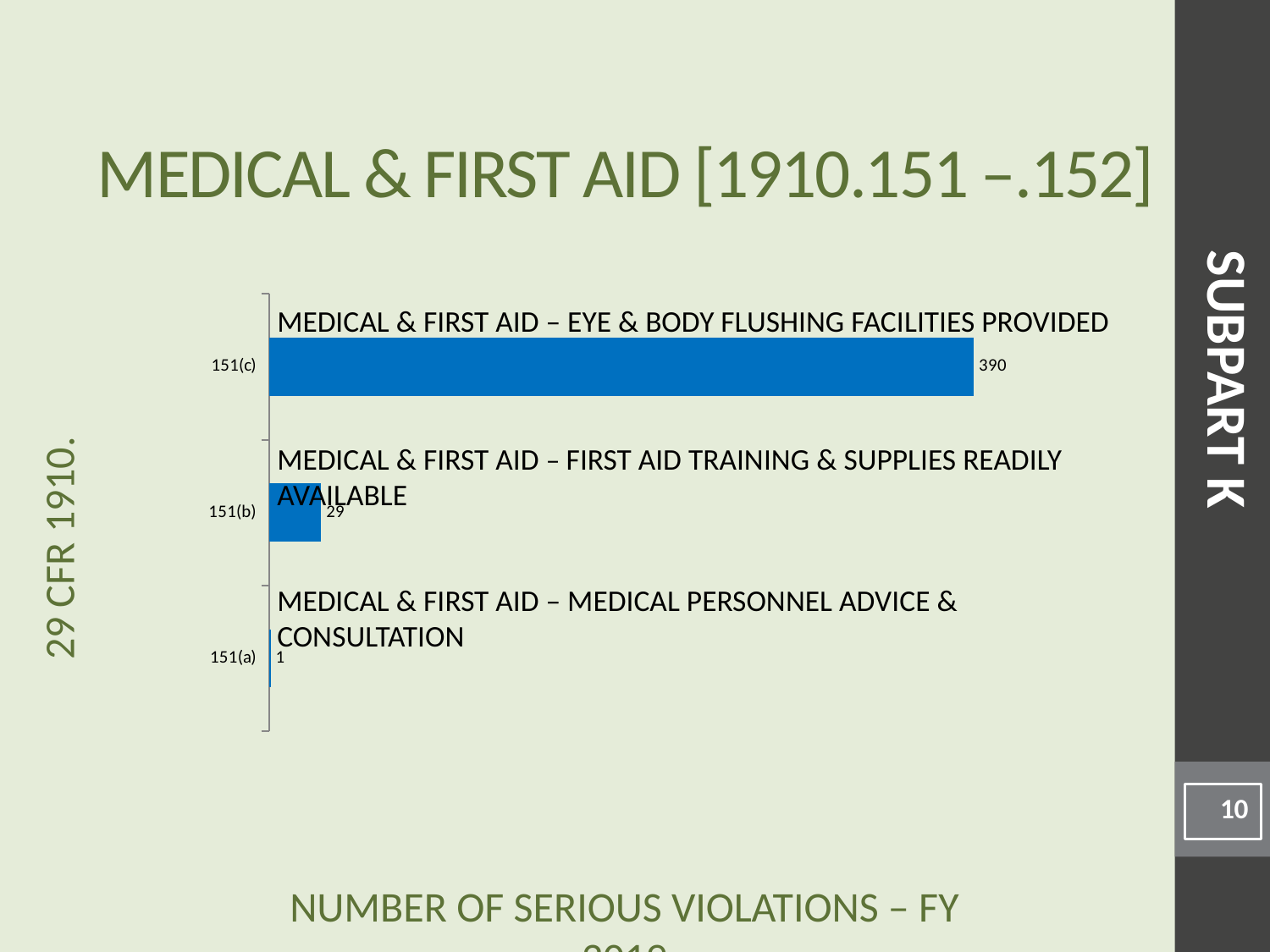
How many categories are shown in the chart? 3 What is the number of serious violations for 151(a)? 1 What is the difference between the values for 151(b) and 151(a)? 28 What is the total number of serious violations across all three categories? 420 What kind of chart is shown on the slide? Bar chart Which has more serious violations, 151(b) or 151(a)? 151(b) What is the number of serious violations for 151(c)? 390 What is the difference between the values for 151(c) and 151(b)? 361 Which category corresponds to 'Eye & Body Flushing Facilities Provided'? 151(c) Which category has the lowest number of serious violations? 151(a) What is the number of serious violations for 151(b)? 29 Which category has the highest number of serious violations? 151(c)